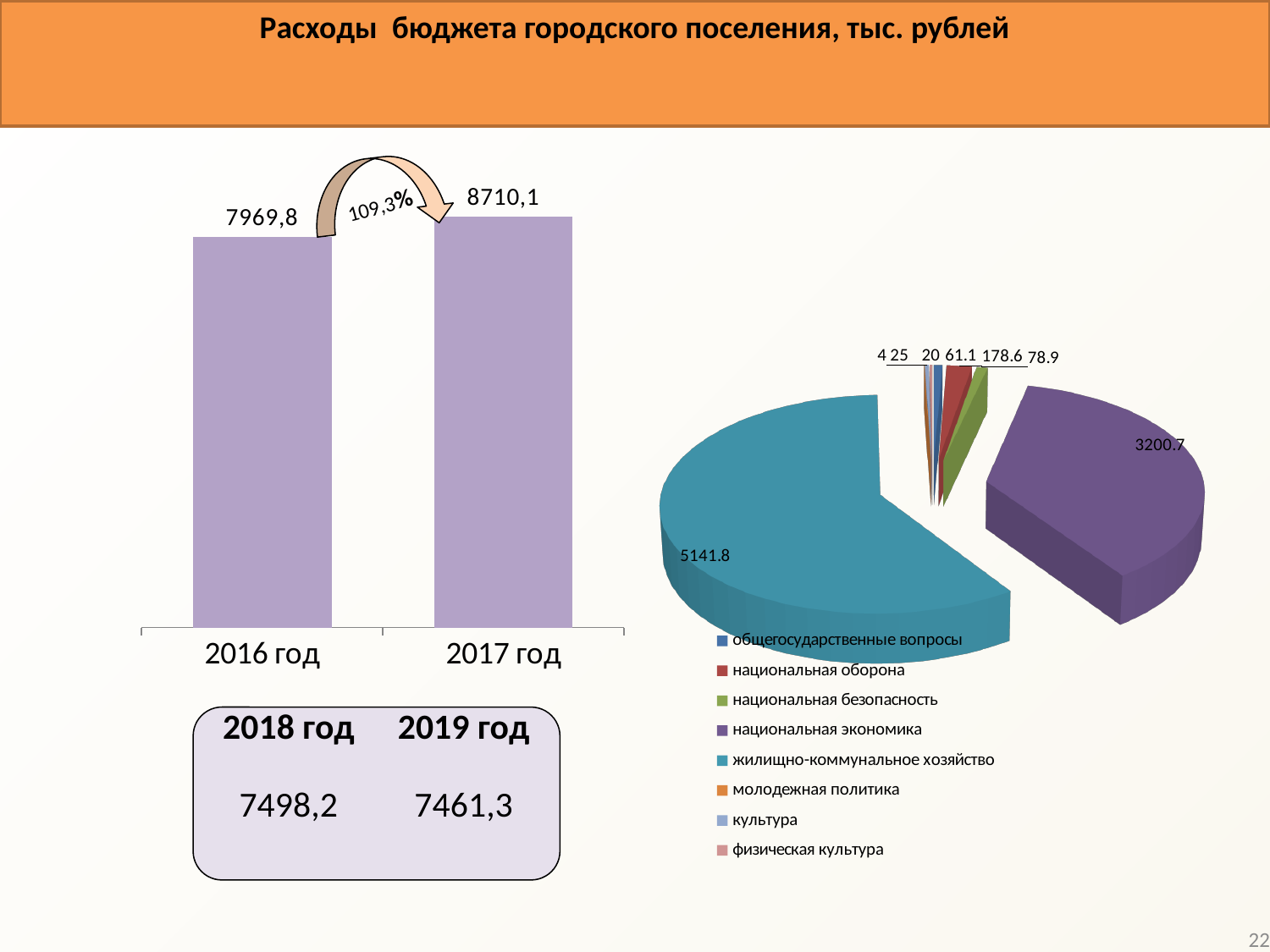
On the bar chart on the left, what is the difference between the 2017 год and 2016 год values? 740,3 On the bar chart on the left, what is the value for 2016 год? 7969,8 On the pie chart on the right, what is the value for национальная экономика? 3200.7 On the pie chart on the right, which category has the largest slice? жилищно-коммунальное хозяйство On the pie chart on the right, what is the value for жилищно-коммунальное хозяйство? 5141.8 What kind of chart is shown on the right of the slide? Pie chart On the bar chart on the left, what is the value for 2017 год? 8710,1 On the bar chart on the left, which year has the higher value, 2016 год or 2017 год? 2017 год What kind of chart is shown on the left of the slide? Bar chart On the bar chart on the left, do the values rise or fall from 2016 год to 2017 год? Rise On the bar chart on the left, how many bars are plotted? 2 How many entries does the legend of the pie chart on the right list? 8